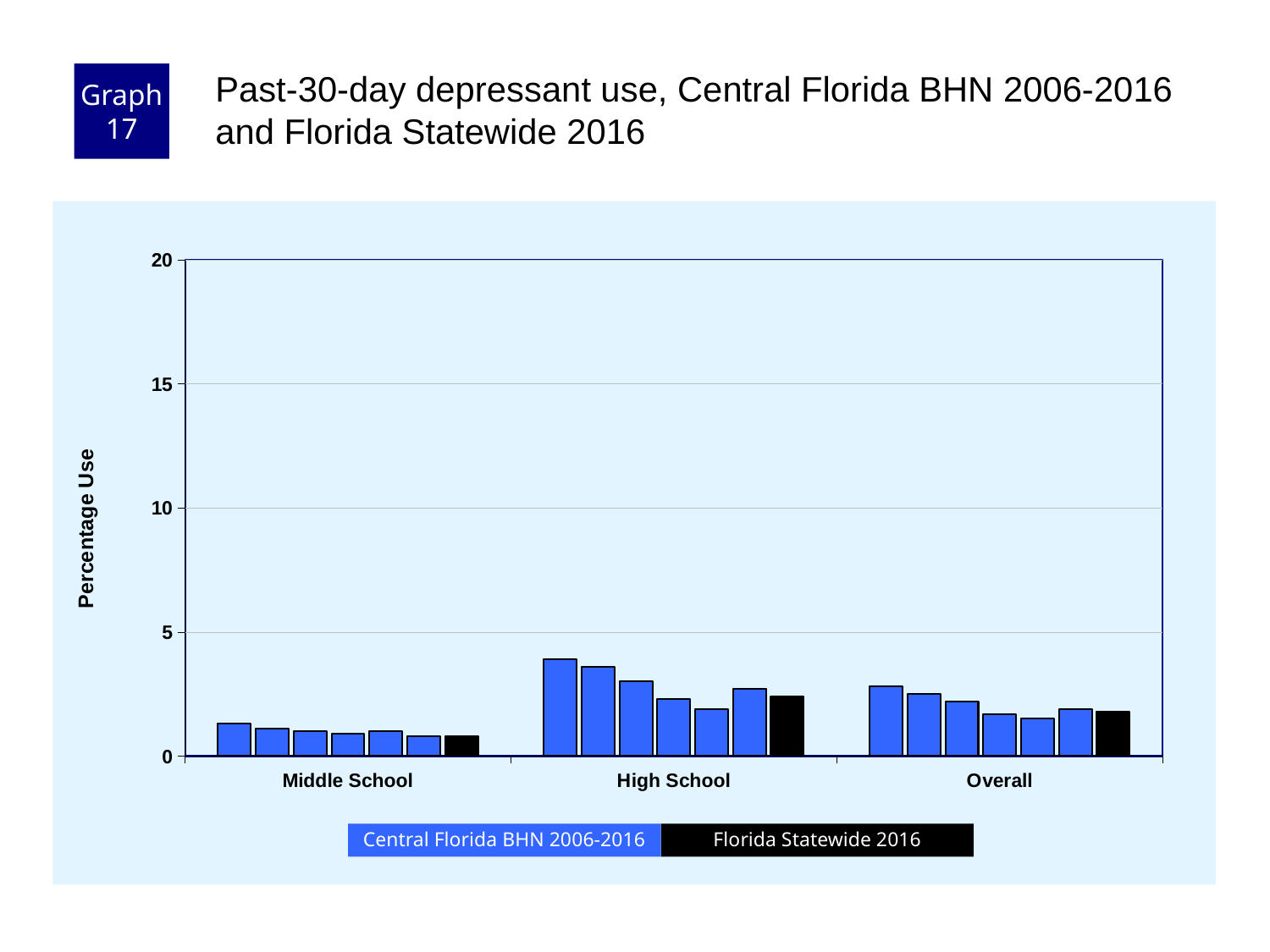
Which is larger, the Florida Statewide 2016 value for High School or for Middle School? High School Is the Florida Statewide 2016 value for Middle School greater or less than 5? less Which colour represents Florida Statewide 2016 in the legend? black Is the Florida Statewide 2016 value for High School greater or less than 5? less What kind of chart is shown on the slide? bar chart Is the Florida Statewide 2016 value for Overall greater or less than 5? less What is the label on the y axis? Percentage Use Which category has the highest Florida Statewide 2016 value? High School Which is larger, the Florida Statewide 2016 value for Overall or for Middle School? Overall Which category has the lowest Florida Statewide 2016 value? Middle School How many categories are shown along the x axis? 3 How many series does the legend list? 2